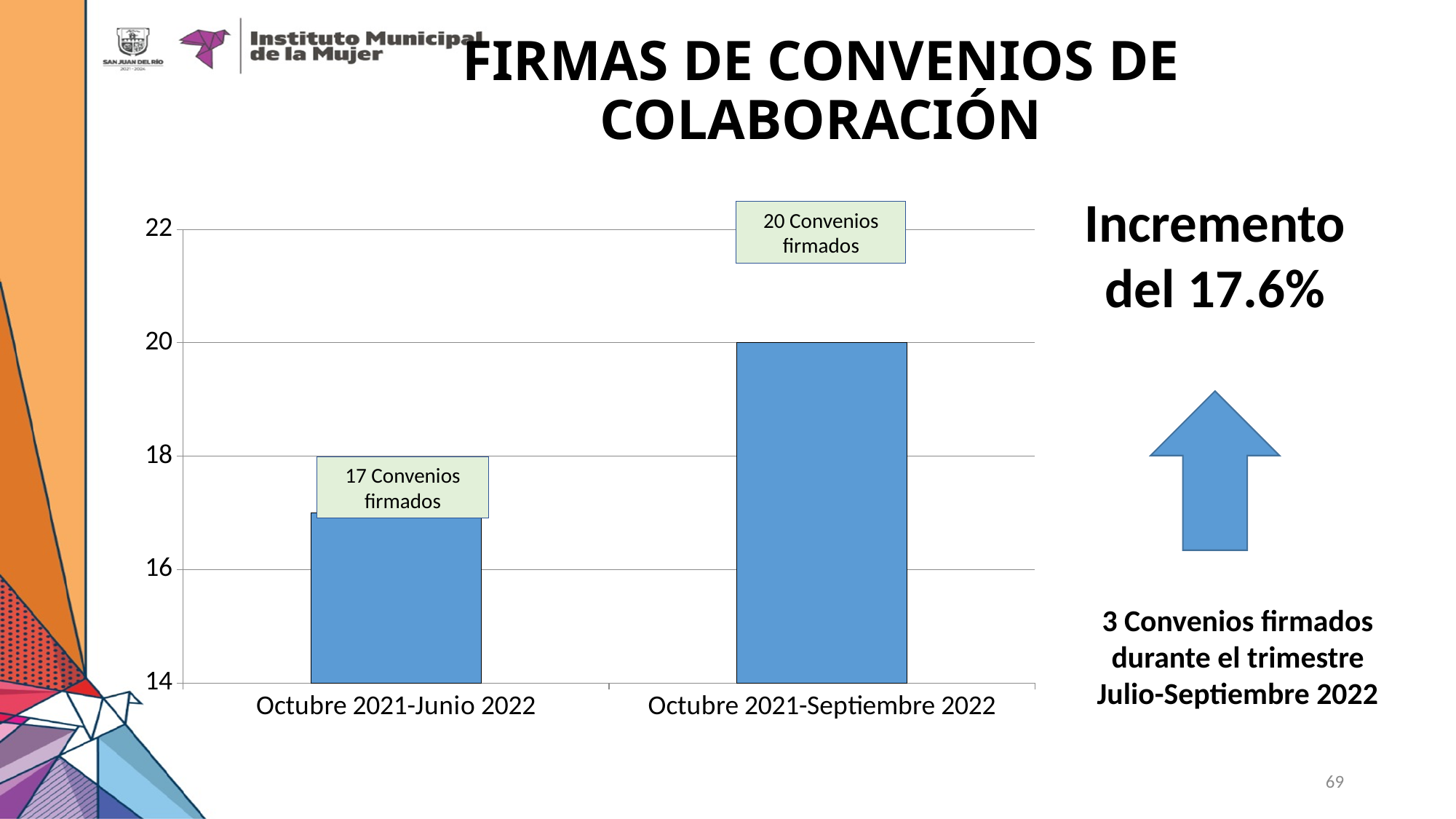
What is the difference between the values for Octubre 2021-Septiembre 2022 and Octubre 2021-Junio 2022? 3 What kind of chart is shown on the slide? bar chart Do the values rise or fall from left to right along the x axis? rise What is the value for Octubre 2021-Junio 2022? 17 Convenios firmados Is the value for Octubre 2021-Septiembre 2022 greater or less than 18? greater What is the value for Octubre 2021-Septiembre 2022? 20 Convenios firmados How many categories are shown on the x axis? 2 What is the title of the slide containing the chart? FIRMAS DE CONVENIOS DE COLABORACIÓN Is the value for Octubre 2021-Junio 2022 greater or less than 18? less Which category has the highest value? Octubre 2021-Septiembre 2022 Which category has the lowest value? Octubre 2021-Junio 2022 Which is larger, the value for Octubre 2021-Junio 2022 or for Octubre 2021-Septiembre 2022? Octubre 2021-Septiembre 2022